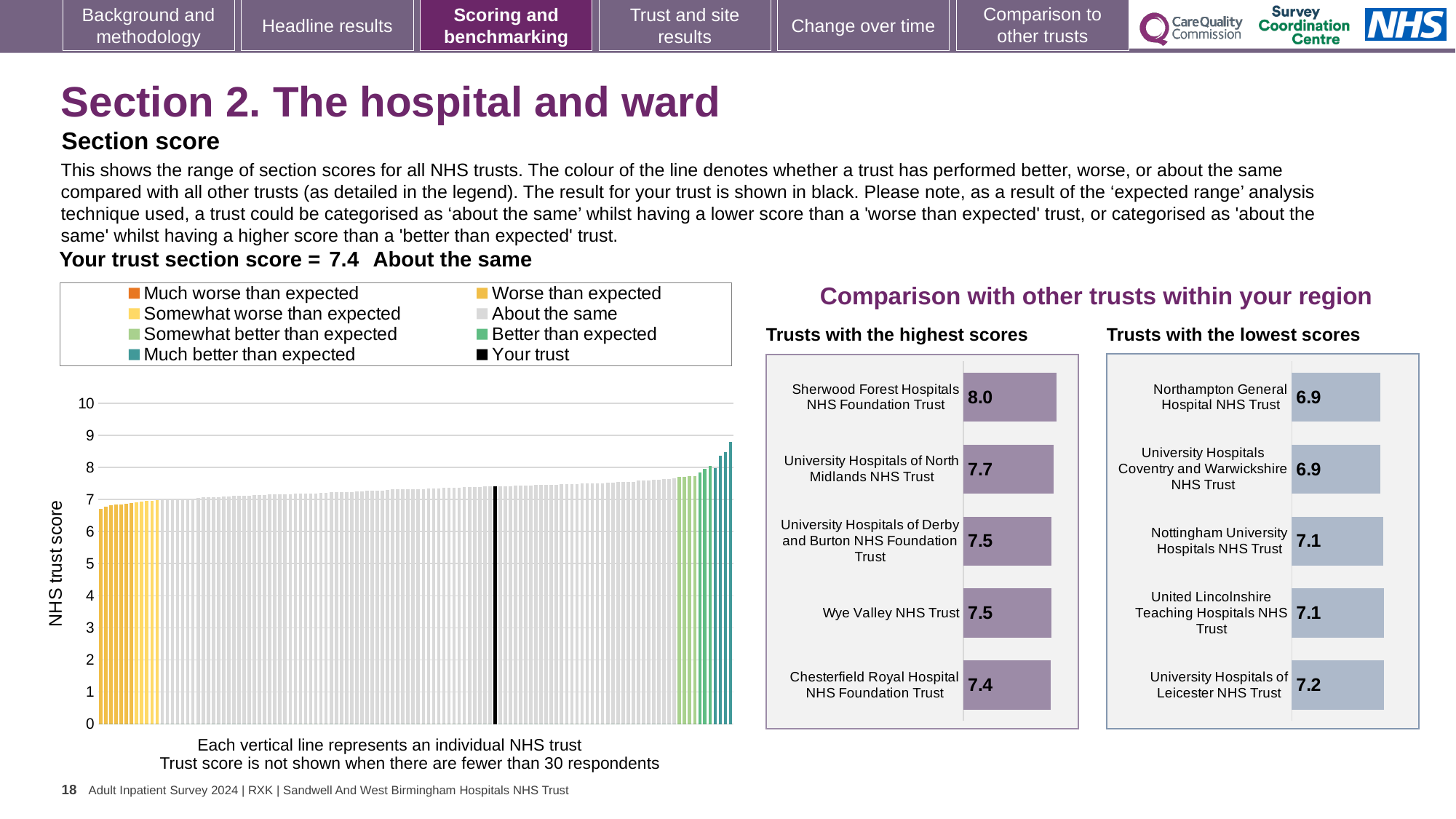
In the 'Trusts with the lowest scores' chart, what is the score for Nottingham University Hospitals NHS Trust? 7.1 In the 'Trusts with the lowest scores' chart, what is the difference between the scores of University Hospitals of Leicester NHS Trust and Northampton General Hospital NHS Trust? 0.3 Which has a higher score: Sherwood Forest Hospitals NHS Foundation Trust in the highest scores chart, or University Hospitals of Leicester NHS Trust in the lowest scores chart? Sherwood Forest Hospitals NHS Foundation Trust In the 'Trusts with the highest scores' chart, what is the score for University Hospitals of North Midlands NHS Trust? 7.7 In the 'Trusts with the highest scores' chart, which trust has the highest score? Sherwood Forest Hospitals NHS Foundation Trust What kind of chart is the main chart on the left showing NHS trust scores? Bar chart In the 'Trusts with the highest scores' chart, what is the difference between the scores of Sherwood Forest Hospitals NHS Foundation Trust and Chesterfield Royal Hospital NHS Foundation Trust? 0.6 In the 'Trusts with the lowest scores' chart, which trust has the highest score shown? University Hospitals of Leicester NHS Trust In the 'Trusts with the highest scores' chart, what is the score for Sherwood Forest Hospitals NHS Foundation Trust? 8.0 In the 'Trusts with the lowest scores' chart, what is the score for University Hospitals of Leicester NHS Trust? 7.2 How many trusts are listed in the 'Trusts with the highest scores' chart? 5 In the main chart on the left showing all NHS trusts, how many entries does the legend list? 8